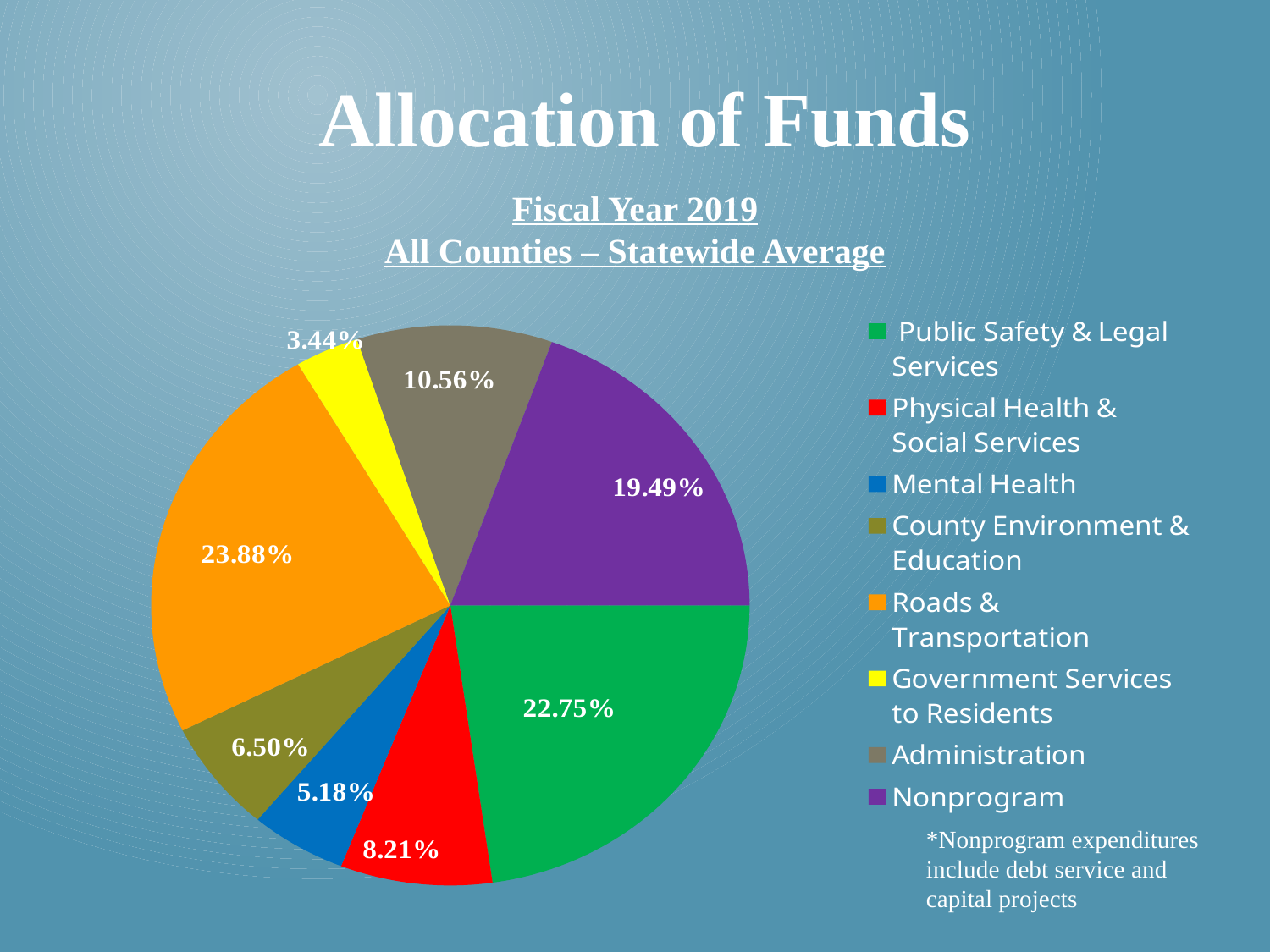
What share of funds goes to Administration? 10.56% Which category receives the largest share of funds? Roads & Transportation Which colour represents Mental Health in the pie chart? Blue What share of funds goes to Roads & Transportation? 23.88% Which category receives the smallest share of funds? Government Services to Residents What share of funds goes to Mental Health? 5.18% How many categories does the pie chart show? 8 What is the difference in percentage points between Physical Health & Social Services and County Environment & Education? 1.71 What kind of chart is shown on the slide? Pie chart What share of funds goes to Nonprogram? 19.49% Which receives a larger share of funds, Administration or Nonprogram? Nonprogram What share of funds goes to Public Safety & Legal Services? 22.75%